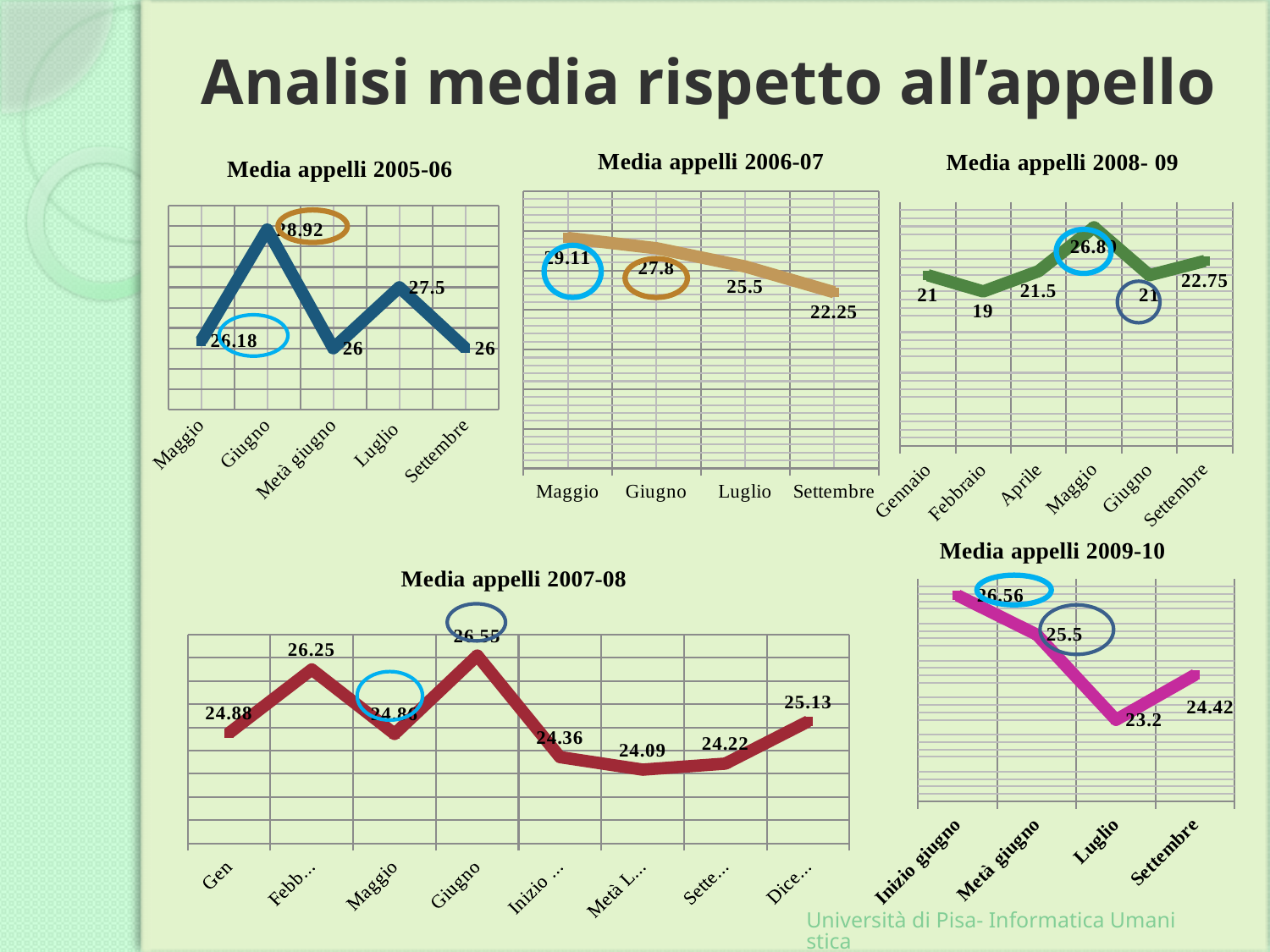
In the 'Media appelli 2008- 09' chart, what is the difference between the values for Settembre and Gennaio? 1.75 In the 'Media appelli 2009-10' chart, what is the value for Luglio? 23.2 In the 'Media appelli 2007-08' chart, which category has the highest value? Giugno In the 'Media appelli 2008- 09' chart, which month has the lowest value? Febbraio In the 'Media appelli 2006-07' chart, what is the value for Settembre? 22.25 In the 'Media appelli 2009-10' chart, which category has the lowest value? Luglio In the 'Media appelli 2007-08' chart, what is the difference between the values for Febb... and Gen? 1.37 What kind of chart is 'Media appelli 2005-06'? line chart How many categories are shown on the x axis of the 'Media appelli 2006-07' chart? 4 In the 'Media appelli 2005-06' chart, which is larger, the value for Luglio or the value for Settembre? Luglio In the 'Media appelli 2006-07' chart, do the values rise or fall from Maggio to Settembre? fall In the 'Media appelli 2008- 09' chart, what is the value for Settembre? 22.75